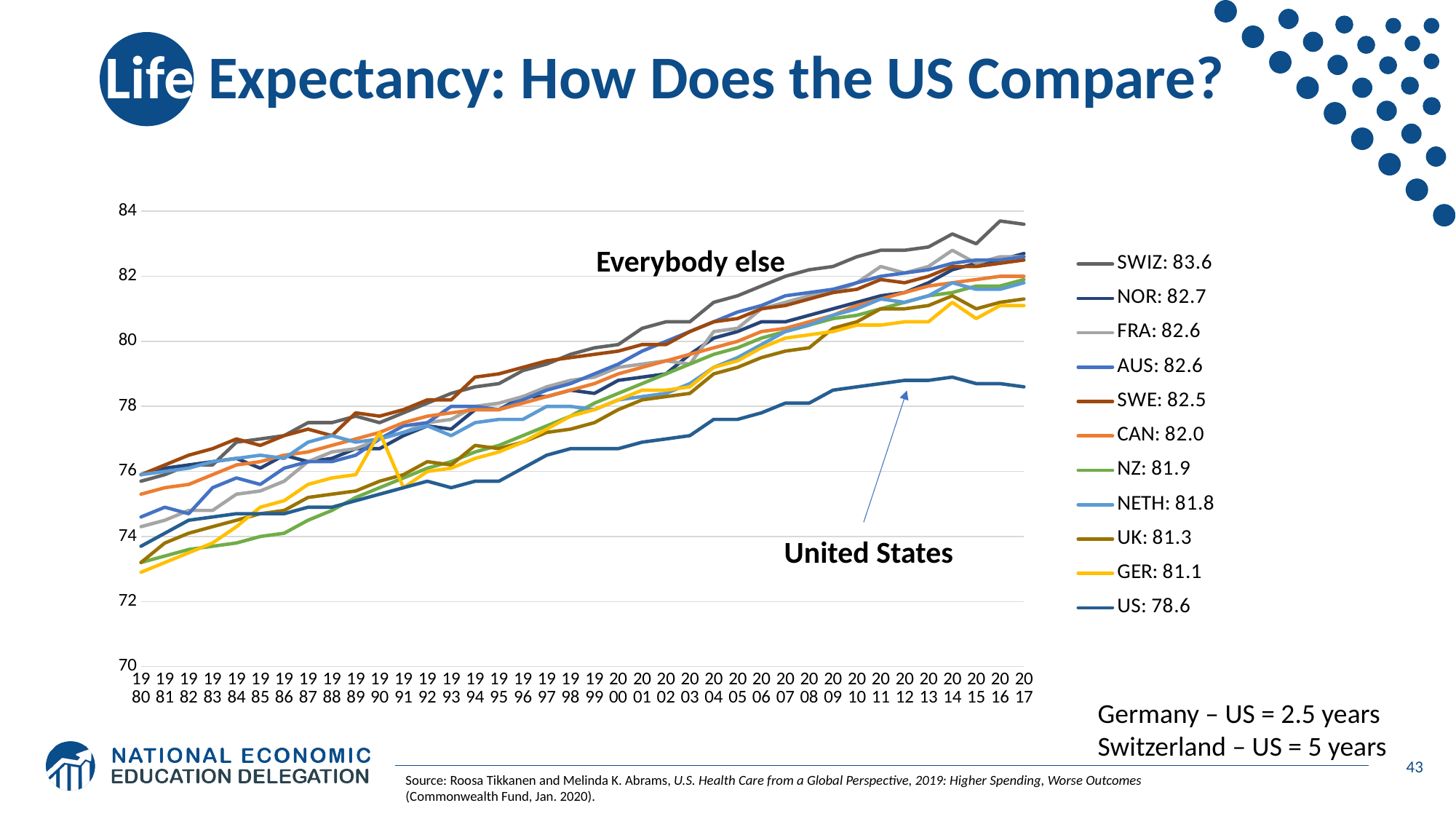
What is the life expectancy value shown for SWIZ in the legend? 83.6 Does the US line generally rise or fall from 1980 to 2017? rise What type of chart is shown on the slide? line chart What is the life expectancy value shown for GER in the legend? 81.1 What is the difference between the legend values for SWIZ and the US? 5.0 Is the value for the US in 2000 greater or less than 78? less How many years are plotted along the x axis? 38 Which country has the lowest life expectancy value in the legend? US What is the life expectancy value shown for the US in the legend? 78.6 How many series does the legend list? 11 Which country has the highest life expectancy value in the legend? SWIZ Which has a higher legend value, NOR or CAN? NOR